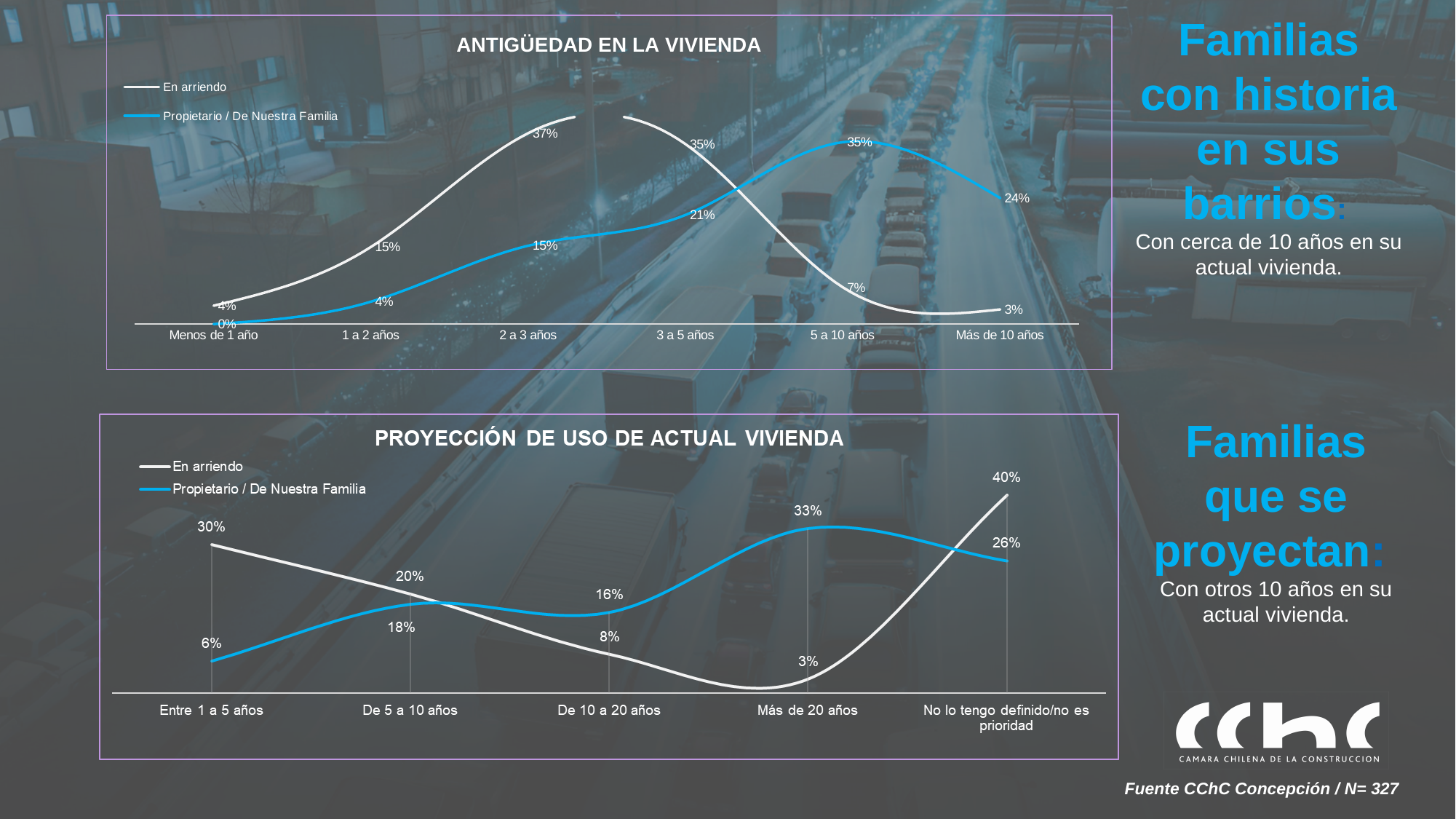
In the chart titled ANTIGÜEDAD EN LA VIVIENDA, what is the value for En arriendo at 2 a 3 años? 37% In the chart titled ANTIGÜEDAD EN LA VIVIENDA, which category has the lowest value for Propietario / De Nuestra Familia? Menos de 1 año In the chart titled ANTIGÜEDAD EN LA VIVIENDA, what is the value for Propietario / De Nuestra Familia at 5 a 10 años? 35% In the chart titled PROYECCIÓN DE USO DE ACTUAL VIVIENDA, what is the value for En arriendo at No lo tengo definido/no es prioridad? 40% In the chart titled ANTIGÜEDAD EN LA VIVIENDA, what is the difference between En arriendo and Propietario / De Nuestra Familia at 5 a 10 años? 28% In the chart titled ANTIGÜEDAD EN LA VIVIENDA, which series is higher at Más de 10 años? Propietario / De Nuestra Familia In the chart titled ANTIGÜEDAD EN LA VIVIENDA, how many categories are shown on the x axis? 6 In the chart titled PROYECCIÓN DE USO DE ACTUAL VIVIENDA, how many series does the legend list? 2 What kind of chart is the chart titled PROYECCIÓN DE USO DE ACTUAL VIVIENDA? Line chart In the chart titled PROYECCIÓN DE USO DE ACTUAL VIVIENDA, what is the value for Propietario / De Nuestra Familia at Más de 20 años? 33% In the chart titled PROYECCIÓN DE USO DE ACTUAL VIVIENDA, which category has the lowest value for En arriendo? Más de 20 años In the chart titled PROYECCIÓN DE USO DE ACTUAL VIVIENDA, what is the difference between Propietario / De Nuestra Familia and En arriendo at Más de 20 años? 30%